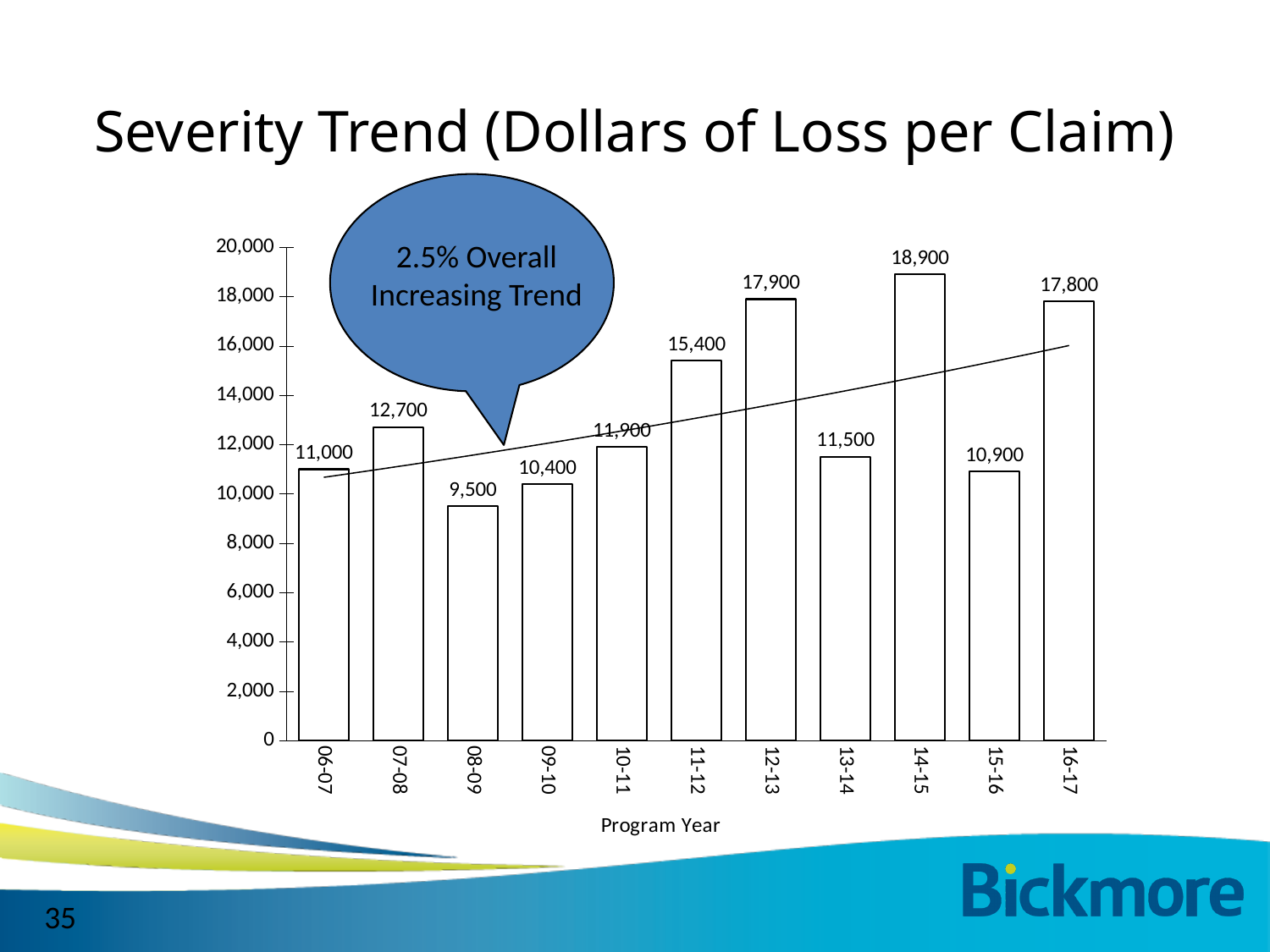
What is the value shown for program year 08-09? 9,500 What is the value shown for program year 15-16? 10,900 What is the difference between the values for 14-15 and 13-14? 7,400 Which is larger, the value for 11-12 or the value for 16-17? 16-17 Which program year has the lowest dollars of loss per claim? 08-09 How many program years are shown on the x axis? 11 What is the label of the x axis? Program Year What kind of chart is shown on the slide? bar chart According to the callout, what is the overall trend in severity? 2.5% Overall Increasing Trend Is the value for 10-11 greater or less than 12,000? less Which program year has the highest dollars of loss per claim? 14-15 What is the dollars of loss per claim for program year 12-13? 17,900